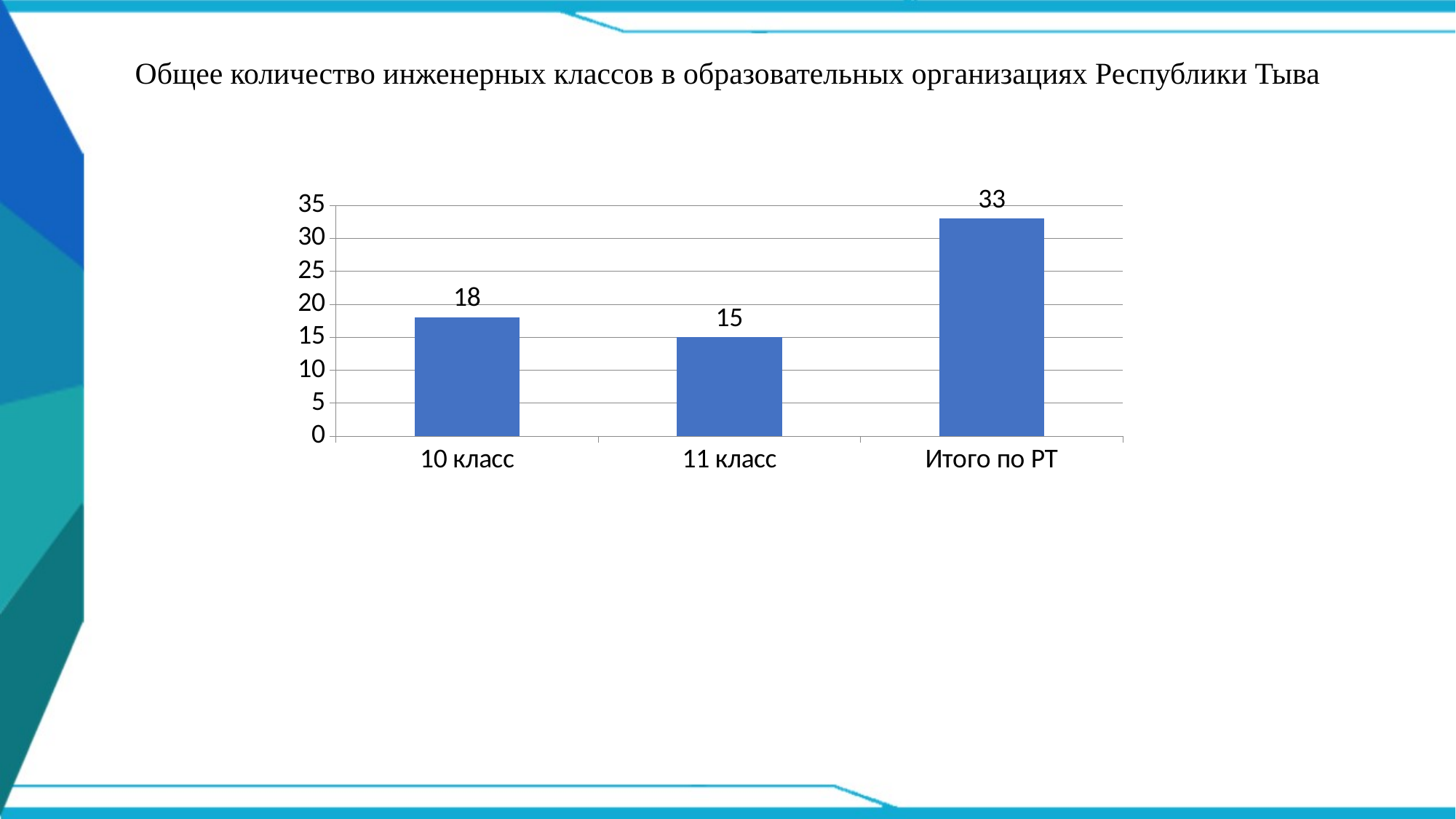
What is the difference between the values for Итого по РТ and 10 класс? 15 What is the value for 11 класс? 15 What is the value for 10 класс? 18 What is the title of the slide? Общее количество инженерных классов в образовательных организациях Республики Тыва Which is larger, the value for 10 класс or the value for 11 класс? 10 класс What is the difference between the values for 10 класс and 11 класс? 3 Which category has the lowest value? 11 класс What is the value for Итого по РТ? 33 What kind of chart is shown on the slide? bar chart How many categories are shown on the x axis? 3 Which category has the highest value? Итого по РТ Is the value for Итого по РТ greater or less than 30? greater